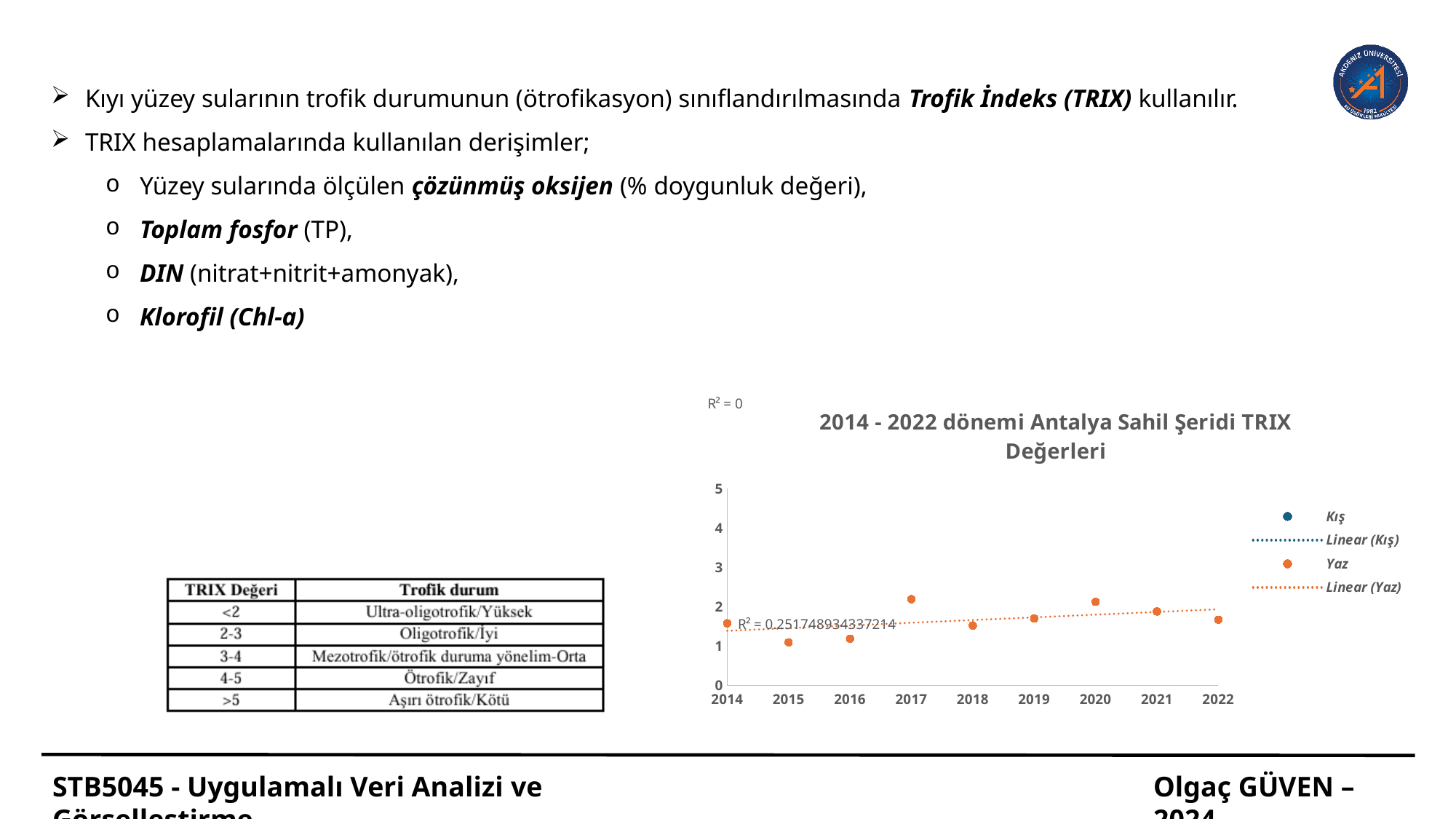
How many entries does the chart legend list? 4 Which is larger, the Yaz value for 2017 or for 2015? 2017 Is the Yaz value for 2017 greater or less than 2? greater Which year has the highest Yaz TRIX value in the chart? 2017 Is the Yaz value for 2018 greater or less than 2? less Is the Yaz value for 2015 greater or less than 2? less What kind of chart is shown on the slide? scatter chart What is the title of the chart? 2014 - 2022 dönemi Antalya Sahil Şeridi TRIX Değerleri Which is larger, the Yaz value for 2020 or for 2016? 2020 Does the Linear (Yaz) trendline rise or fall from 2014 to 2022? rise How many years are shown on the x axis of the chart? 9